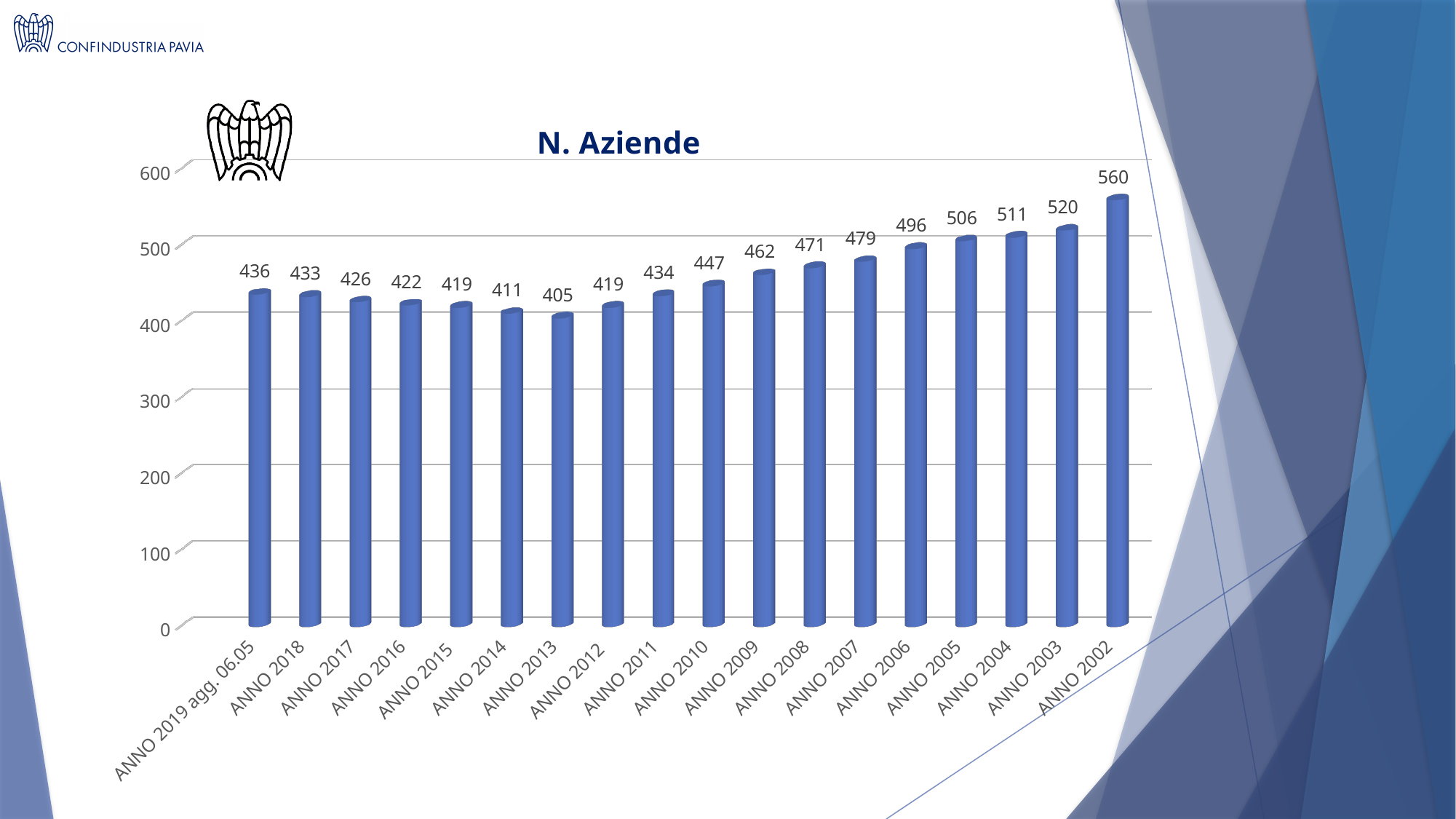
Which category has the highest value? ANNO 2002 Which category has the lowest value? ANNO 2013 What is the difference between the values for ANNO 2002 and ANNO 2013? 155 What kind of chart is shown on the slide? bar chart What is the title of the chart? N. Aziende How many categories are shown on the x axis? 18 What is the value for ANNO 2002? 560 Is the value for ANNO 2005 greater or less than 500? greater Which is larger, the value for ANNO 2010 or the value for ANNO 2016? ANNO 2010 Do the values generally rise or fall from ANNO 2013 to ANNO 2002 along the x axis? rise What is the value for ANNO 2013? 405 What is the value for ANNO 2019 agg. 06.05? 436